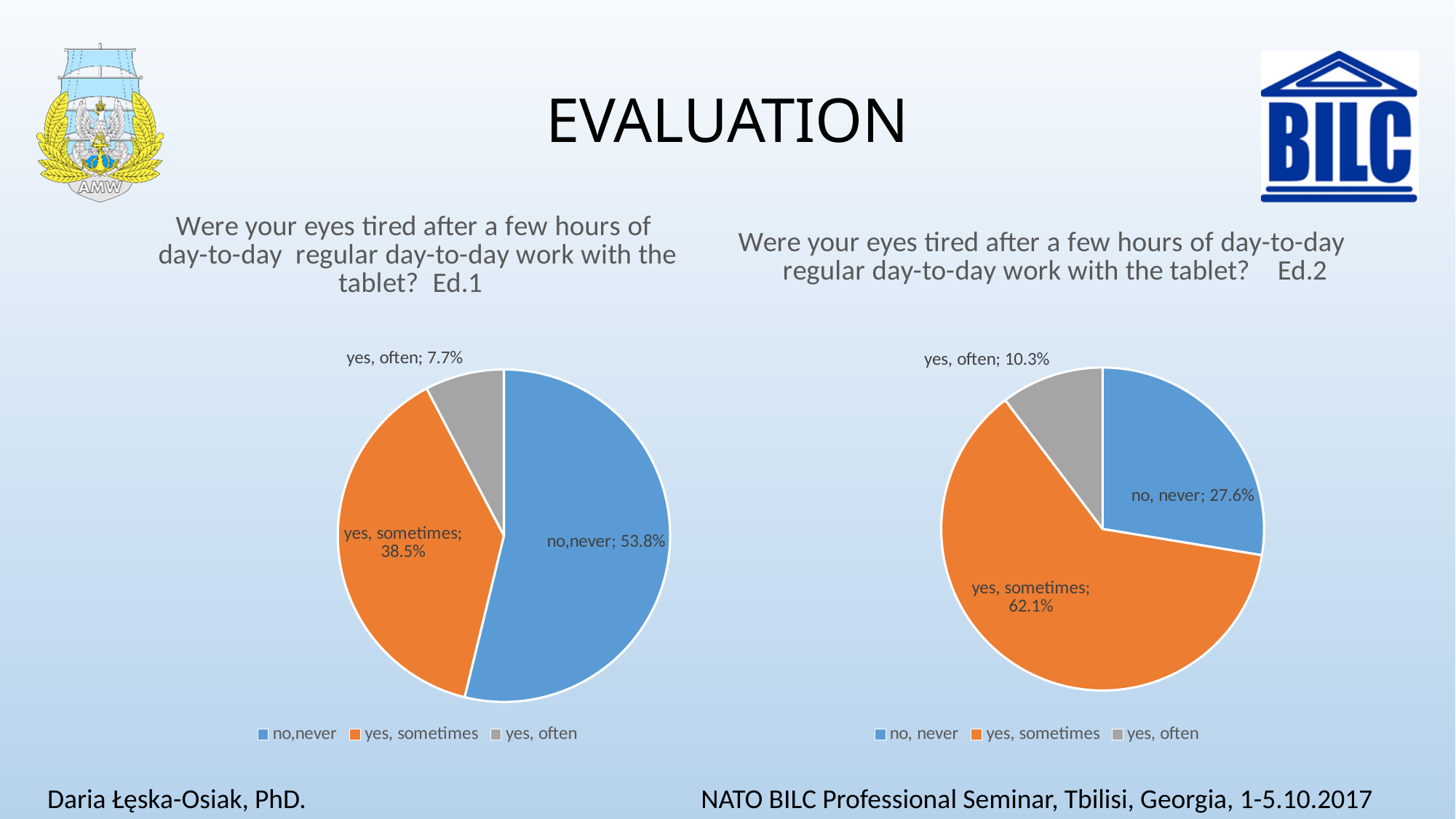
In the Ed.1 pie chart on the left, what percentage answered "yes, often"? 7.7% Which is larger: the "yes, often" share in the Ed.1 chart or the "yes, often" share in the Ed.2 chart? Ed.2 In the Ed.2 pie chart on the right, what percentage answered "yes, sometimes"? 62.1% What type of chart is used for the Ed.2 results on the right? Pie chart In the Ed.1 pie chart on the left, what percentage answered "no,never"? 53.8% In the Ed.2 pie chart on the right, what percentage answered "no, never"? 27.6% How many slices does the Ed.1 pie chart on the left have? 3 In the Ed.1 pie chart on the left, what is the difference between the "no,never" share and the "yes, sometimes" share? 15.3% In the Ed.2 pie chart on the right, which answer has the smallest share? yes, often In the Ed.2 pie chart on the right, what colour is the "yes, sometimes" slice? Orange In the Ed.1 pie chart on the left, which answer has the largest share? no,never In the Ed.2 pie chart on the right, what is the difference between the "yes, sometimes" share and the "no, never" share? 34.5%